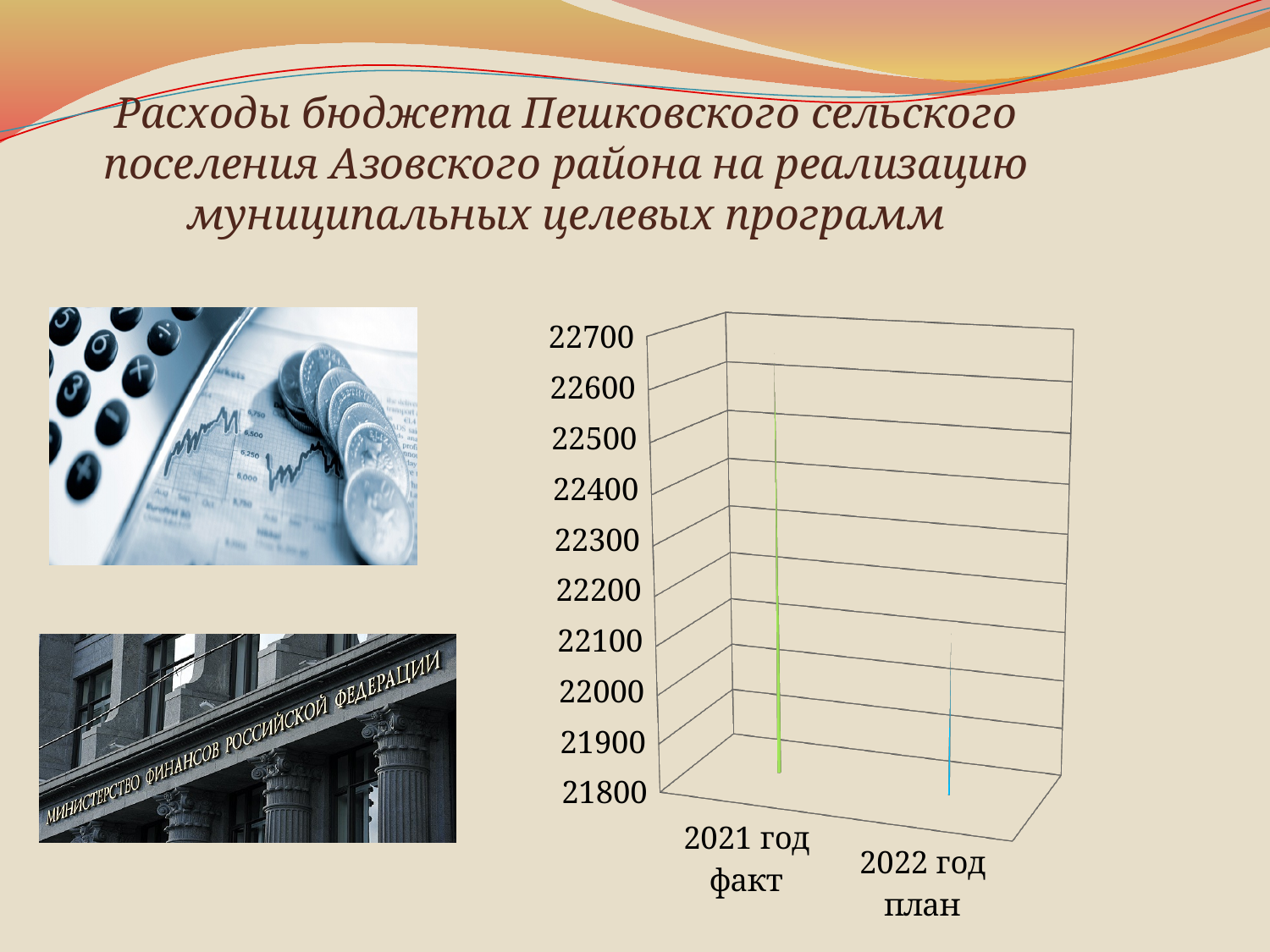
Is the value for 2022 год план greater or less than 22400? less How many categories are shown on the x axis of the chart? 2 What is the highest value shown on the vertical axis of the chart? 22700 Which is larger: the value for 2021 год факт or the value for 2022 год план? 2021 год факт Which category has the lowest value in the chart? 2022 год план Do the values rise or fall from 2021 год факт to 2022 год план? fall What kind of chart is shown on the slide? bar chart Is the value for 2021 год факт greater or less than 22300? greater Which category has the highest value in the chart? 2021 год факт What is the lowest value shown on the vertical axis of the chart? 21800 Is the value for 2022 год план greater or less than 21800? greater